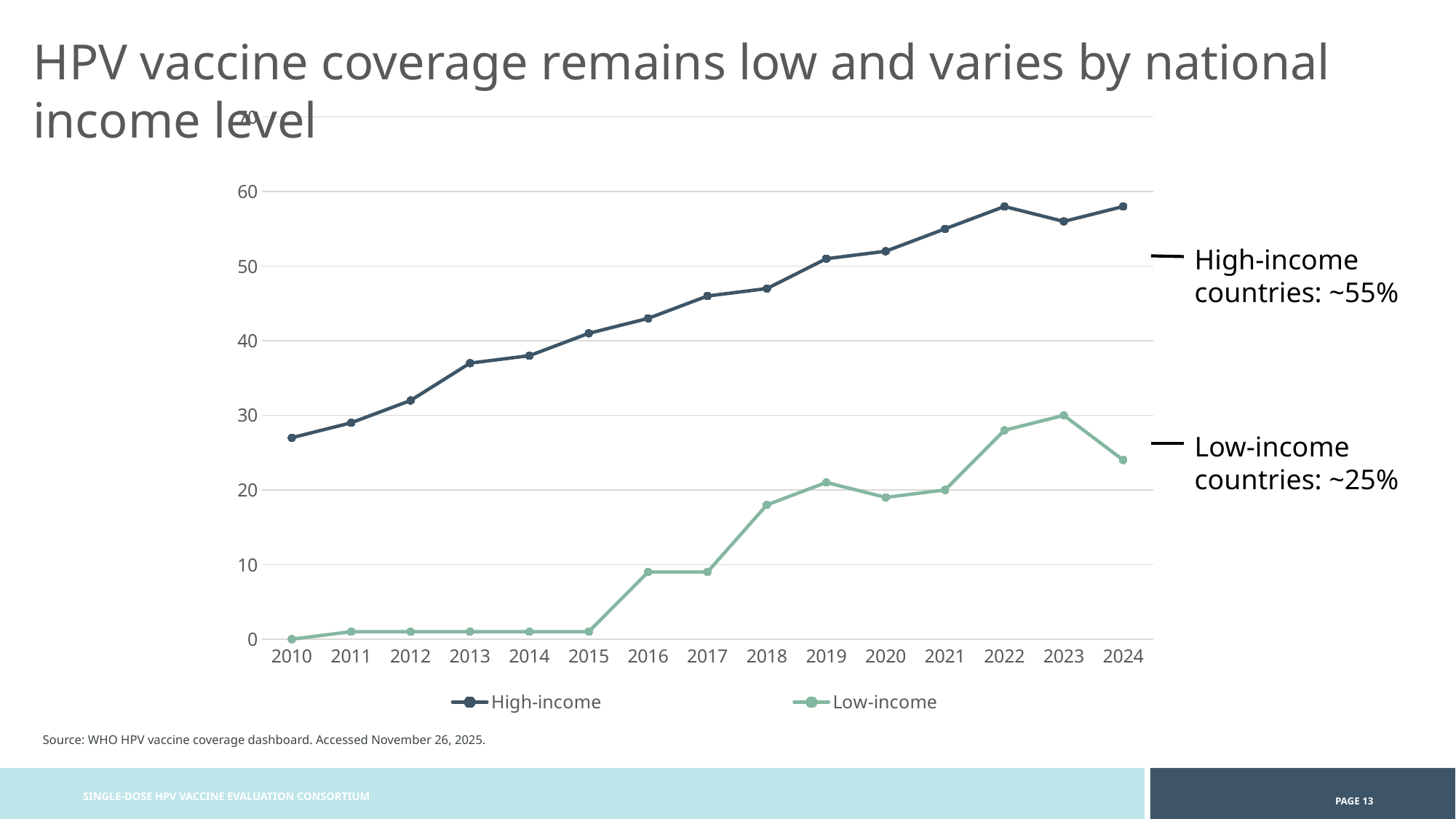
How many years are plotted along the x axis? 15 What kind of chart is shown on the slide? line chart How many series does the legend list? 2 In which year is the High-income series at its lowest value? 2010 In which year does the Low-income series reach its highest value? 2023 Is the High-income value for 2024 greater or less than 50? greater Is the High-income value for 2010 greater or less than 30? less Is the Low-income value for 2016 greater or less than 10? less Which series has the larger value in 2024, High-income or Low-income? High-income What is the Low-income value for 2010? 0 Does the High-income series generally rise or fall from 2010 to 2024? rise